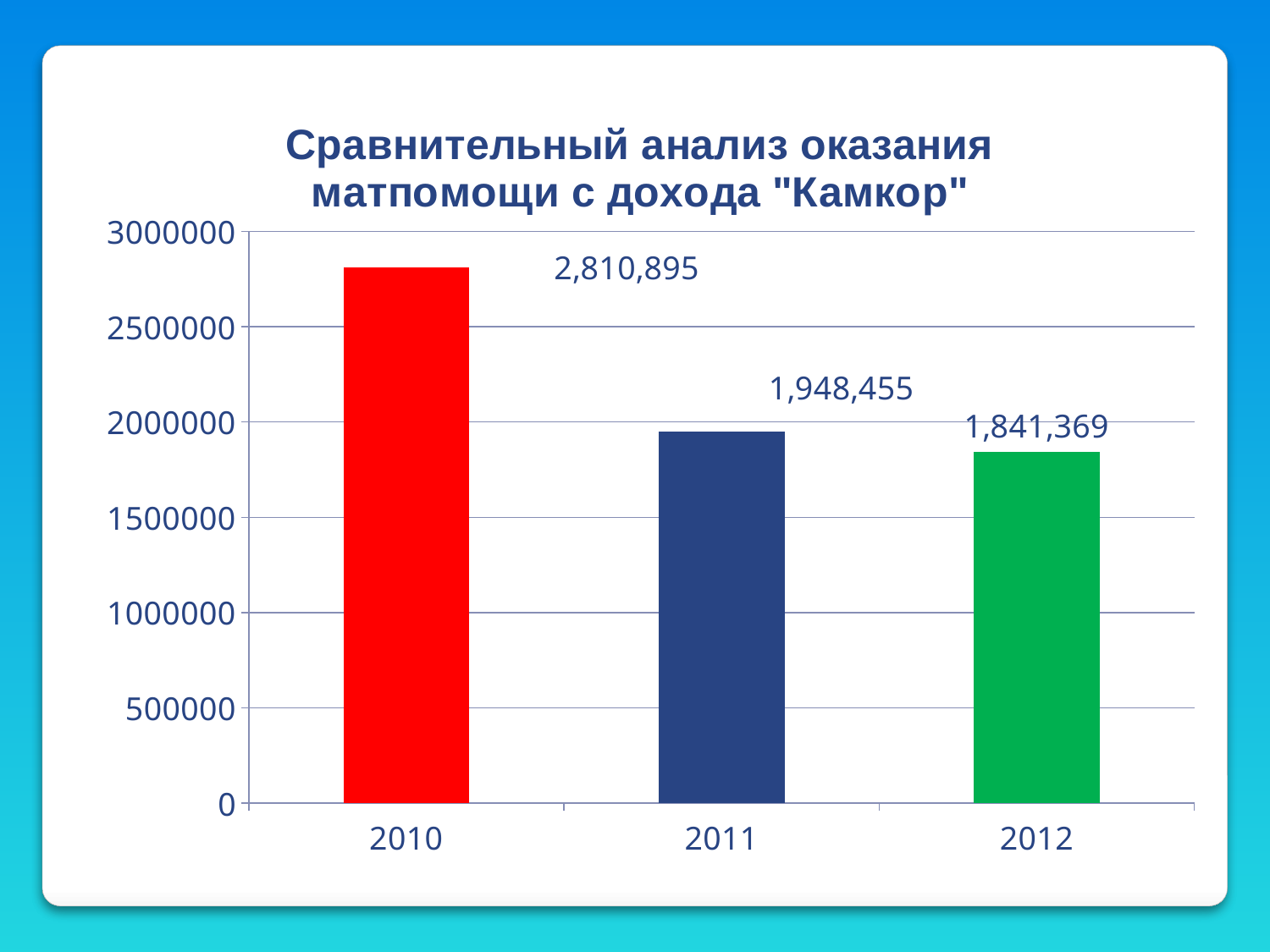
Which year has the lowest value? 2012 What kind of chart is shown on the slide? bar chart Which is larger, the value for 2010 or the value for 2012? 2010 Which year has the highest value? 2010 What is the difference between the values for 2010 and 2011? 862,440 What is the value for 2012? 1,841,369 Is the value for 2011 greater or less than 1500000? greater How many years are shown on the chart? 3 What is the value for 2010? 2,810,895 Do the values rise or fall from 2010 to 2012? fall What is the difference between the values for 2011 and 2012? 107,086 What is the value for 2011? 1,948,455